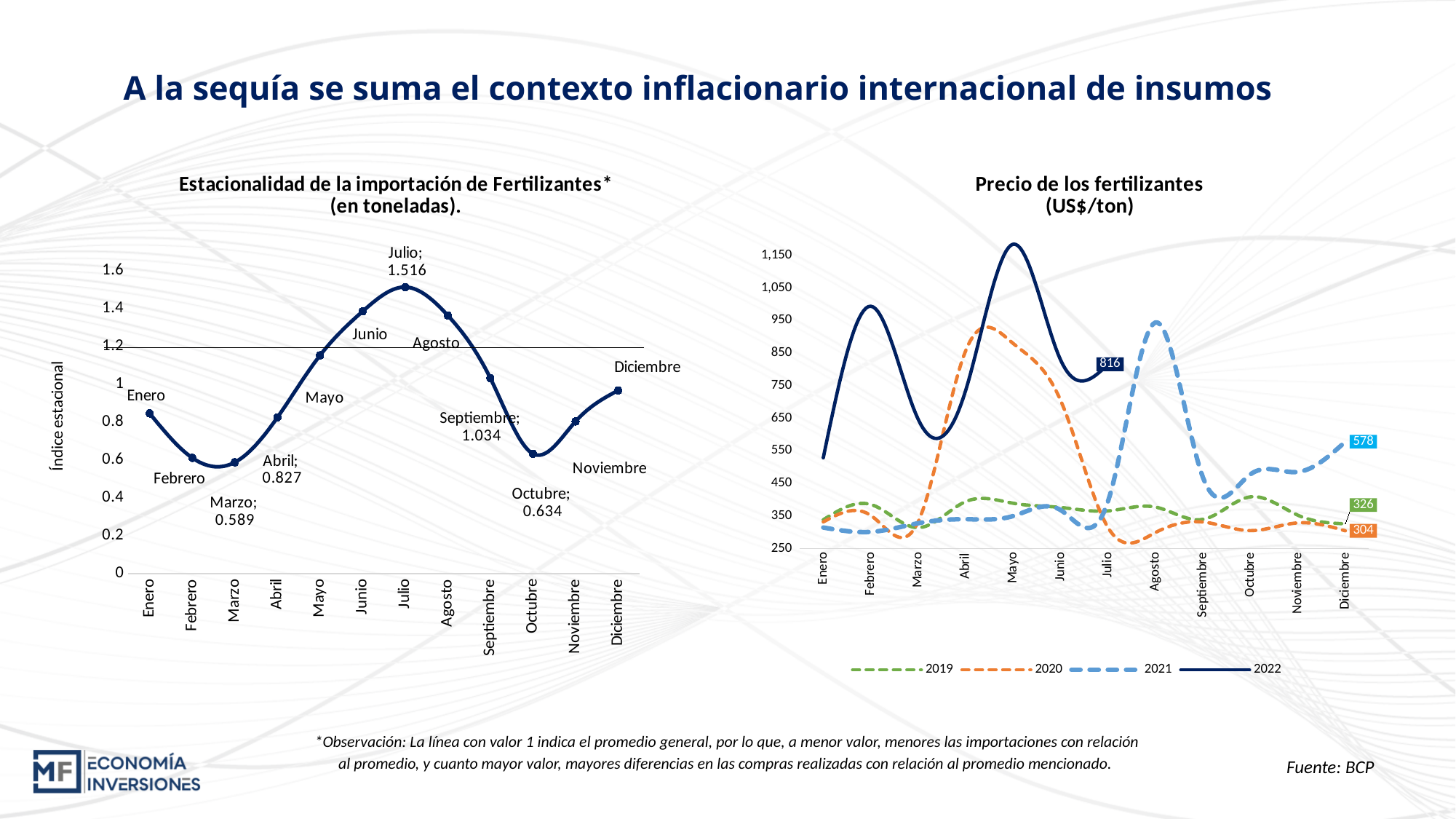
In the chart 'Precio de los fertilizantes (US$/ton)', how many series does the legend list? 4 In the chart 'Precio de los fertilizantes (US$/ton)', which series has the larger value in Diciembre, 2019 or 2020? 2019 In the chart 'Estacionalidad de la importación de Fertilizantes', how many months are plotted on the x axis? 12 In the chart 'Estacionalidad de la importación de Fertilizantes', which month has the lowest index value? Marzo In the chart 'Estacionalidad de la importación de Fertilizantes', what is the value for Julio? 1.516 In the chart 'Precio de los fertilizantes (US$/ton)', what is the labelled value for 2021 in Diciembre? 578 In the chart 'Estacionalidad de la importación de Fertilizantes', what is the difference between the values for Julio and Marzo? 0.927 What kind of chart is 'Estacionalidad de la importación de Fertilizantes'? Line chart In the chart 'Estacionalidad de la importación de Fertilizantes', what is the value for Marzo? 0.589 In the chart 'Estacionalidad de la importación de Fertilizantes', which month has the highest index value? Julio In the chart 'Precio de los fertilizantes (US$/ton)', what is the labelled value for 2022 in Julio? 816 In the chart 'Precio de los fertilizantes (US$/ton)', is the value for 2022 in Mayo greater or less than 1,050? greater